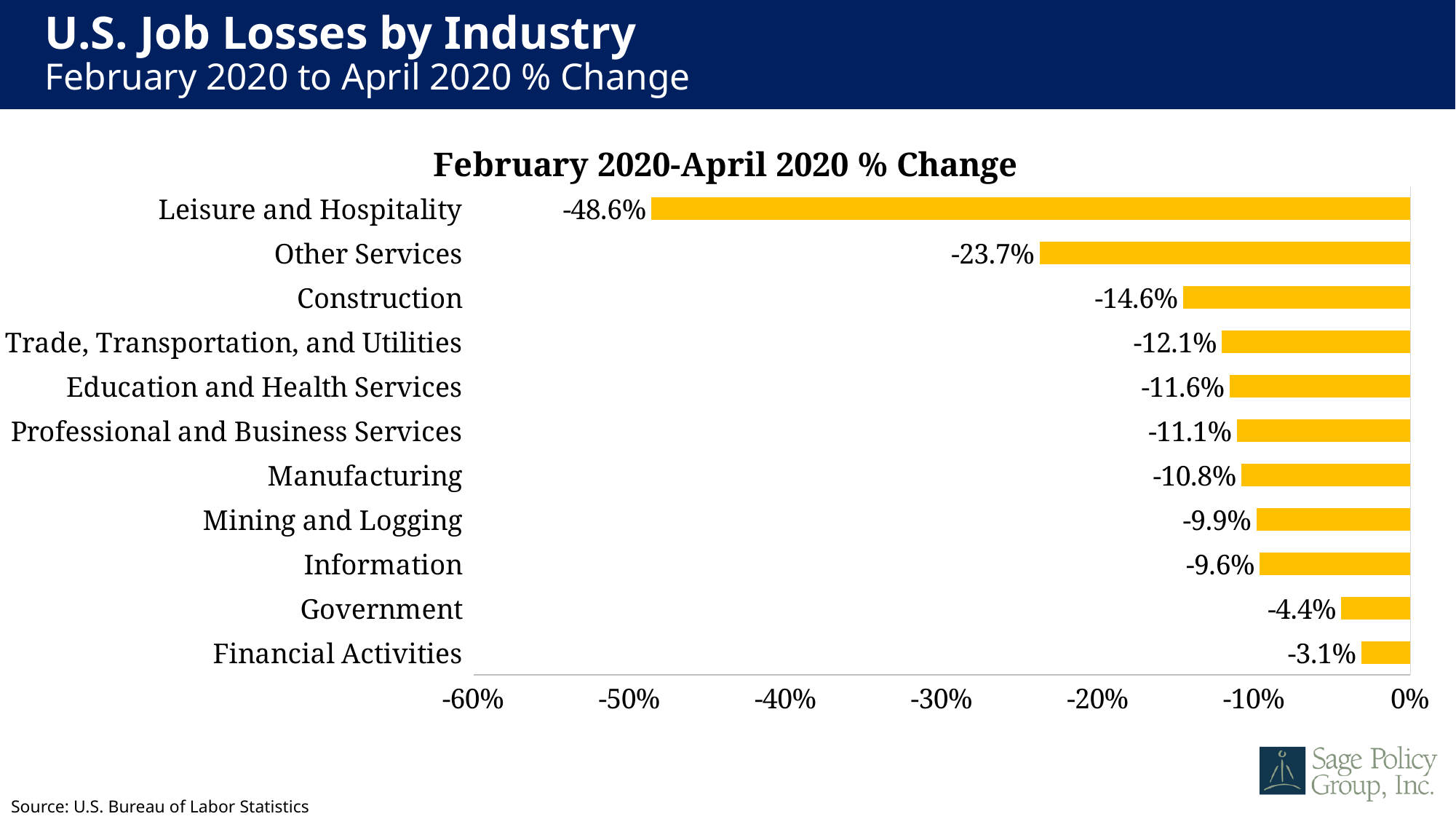
What is the % change shown for Mining and Logging? -9.9% What is the title of the chart? February 2020-April 2020 % Change How many industries are shown in the chart? 11 What is the February 2020 to April 2020 % change for Leisure and Hospitality? -48.6% Which industry had the largest percentage job loss? Leisure and Hospitality Which industry had the smallest percentage job loss? Financial Activities What is the % change shown for Construction? -14.6% What type of chart is shown on the slide? Bar chart What is the % change shown for Government? -4.4% What is the difference between the % change for Leisure and Hospitality and Other Services? 24.9 percentage points What is the source cited for the chart data? U.S. Bureau of Labor Statistics Which industry had a larger percentage job loss, Construction or Manufacturing? Construction